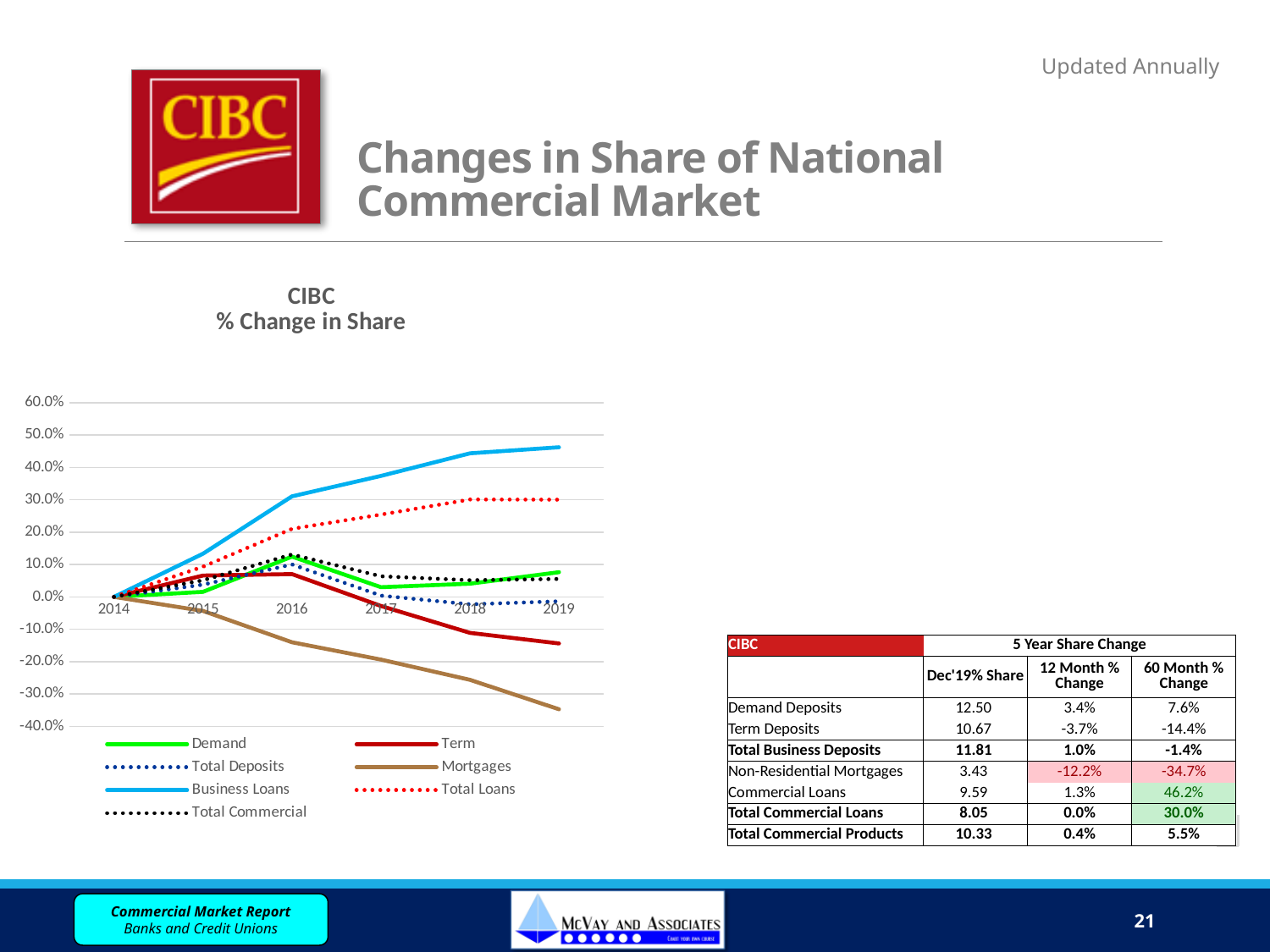
What is the title of the chart? CIBC % Change in Share Which is larger in 2019, Business Loans or Total Loans? Business Loans How many series does the chart legend list? 7 Is the value for Mortgages in 2019 greater or less than -30.0%? less Which series has the highest value in 2019? Business Loans Is the value for Term in 2019 greater or less than -10.0%? less Is the value for Business Loans in 2019 greater or less than 40.0%? greater Do the values for Mortgages rise or fall from 2014 to 2019? fall What kind of chart is shown on the slide? line chart How many years are shown along the x axis of the chart? 6 Which series has the lowest value in 2019? Mortgages